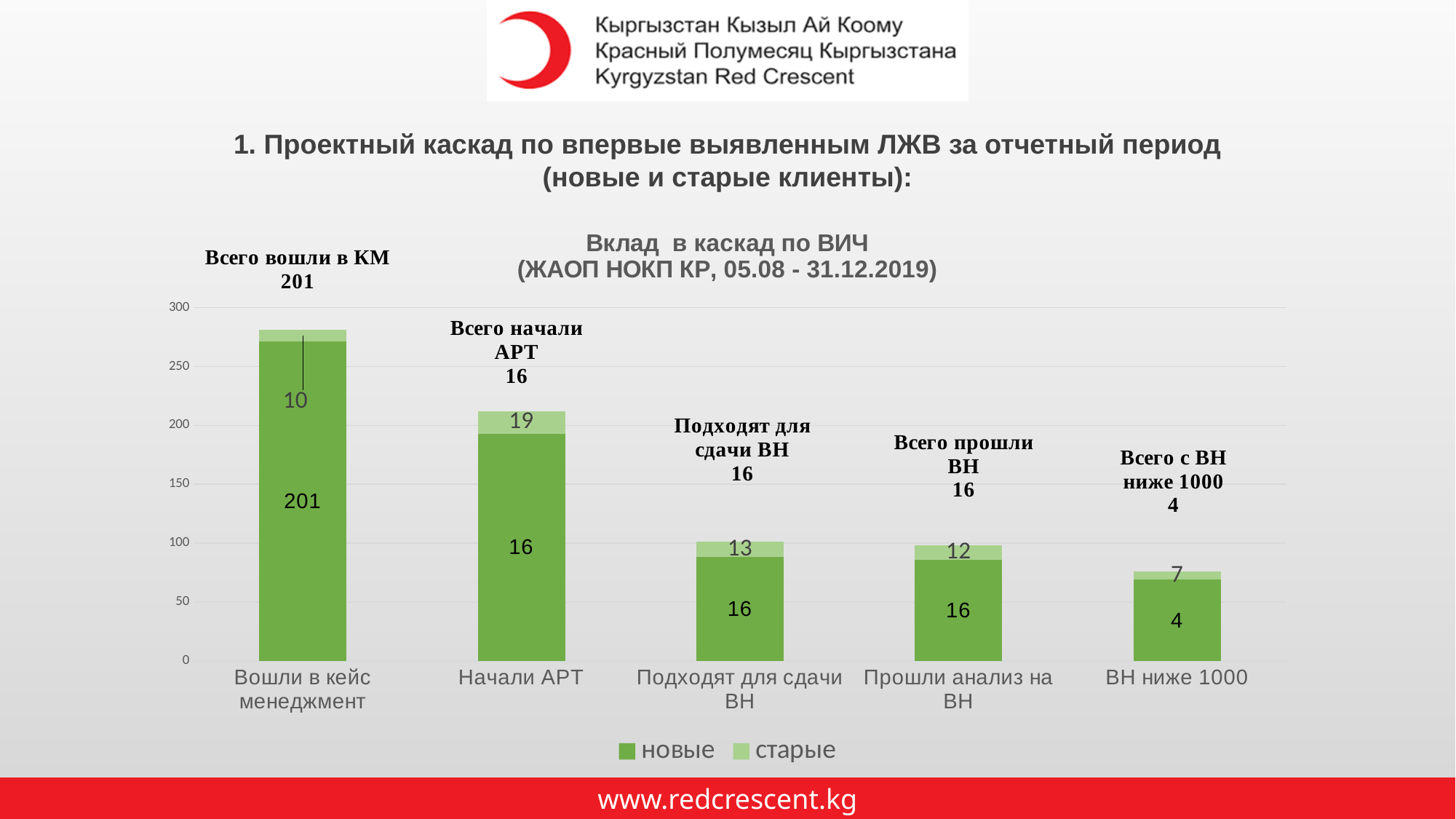
What kind of chart is shown on the slide? Stacked bar chart What are the two legend entries of the chart? новые and старые Which category has the lowest value in the старые series? ВН ниже 1000 For Начали АРТ, which series has the larger value, новые or старые? новые What is the value of the старые series for Начали АРТ? 19 How many series does the legend list? 2 What is the value of the старые series for ВН ниже 1000? 7 Which category has the highest value in the новые series? Вошли в кейс менеджмент How many categories are shown on the x axis? 5